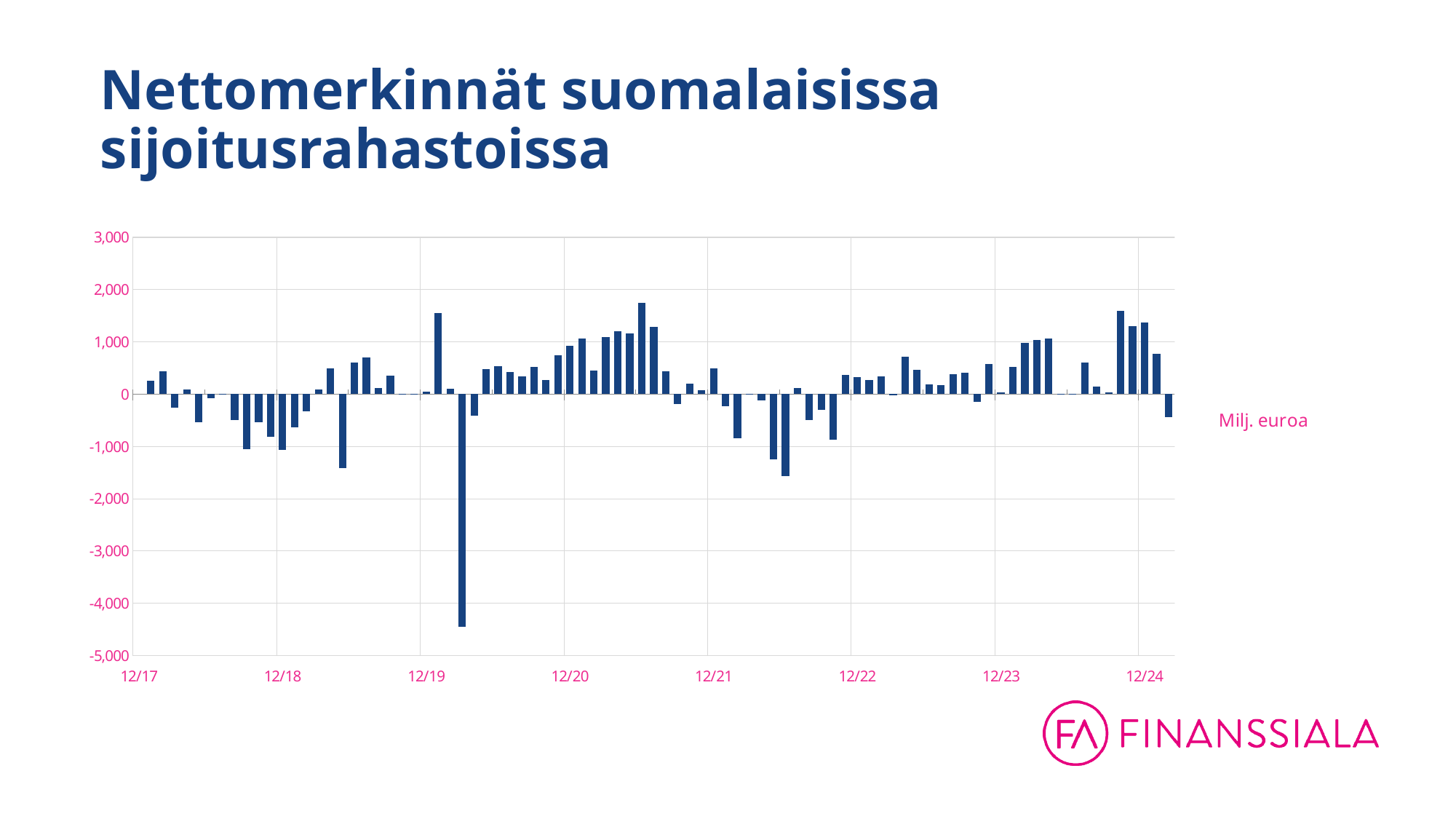
What kind of chart is shown on the slide? Bar chart What is the title of the chart on the slide? Nettomerkinnät suomalaisissa sijoitusrahastoissa What unit label is shown next to the chart? Milj. euroa Which is larger in magnitude: the lowest bar on the chart or the highest bar on the chart? The lowest bar Is the highest value on the chart greater or less than 1,000? greater Is the lowest value on the chart greater or less than -4,000? less Is the value for 12/20 greater or less than 0? greater What is the highest tick value shown on the y axis? 3,000 How many date labels are shown on the x axis? 8